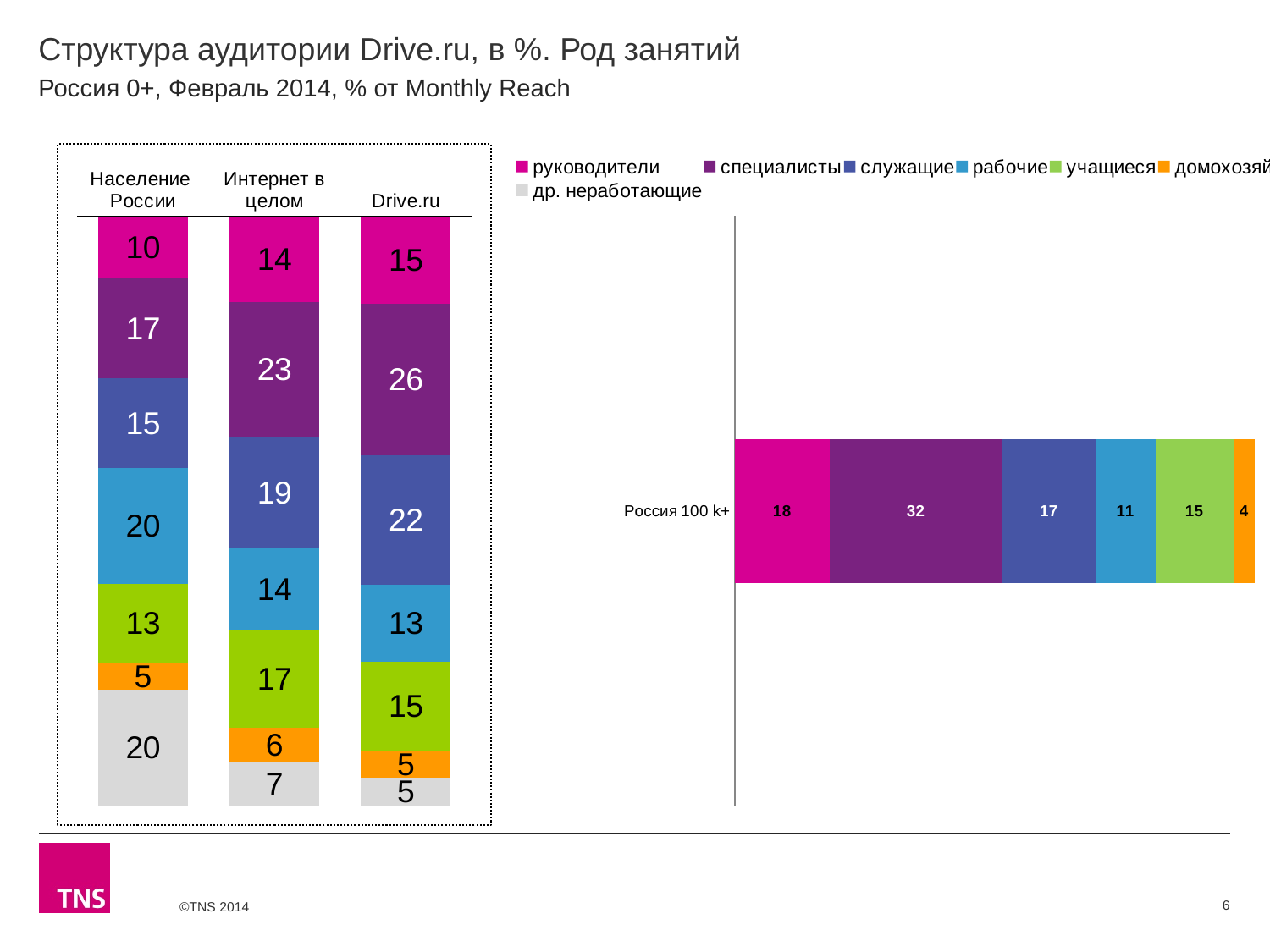
In the left stacked bar chart, what is the value for др. неработающие in the Население России column? 20 How many columns (categories) are shown in the left stacked bar chart? 3 What kind of chart is the right chart labelled Россия 100 k+? bar chart In the right bar chart (Россия 100 k+), what is the value for руководители? 18 In the right bar chart (Россия 100 k+), which occupation group has the largest segment? специалисты In the left stacked bar chart, which column has the larger value for учащиеся: Интернет в целом or Drive.ru? Интернет в целом In the left stacked bar chart, what is the value for специалисты in the Drive.ru column? 26 In the left stacked bar chart, what is the difference between the специалисты value for Drive.ru and for Население России? 9 In the left stacked bar chart, does the value for руководители rise or fall going from Население России to Интернет в целом to Drive.ru? rise How many series does the legend list? 7 In the left stacked bar chart, which occupation group has the lowest value in the Интернет в целом column? домохозяйки In the left stacked bar chart, which of the three columns has the highest value for специалисты? Drive.ru